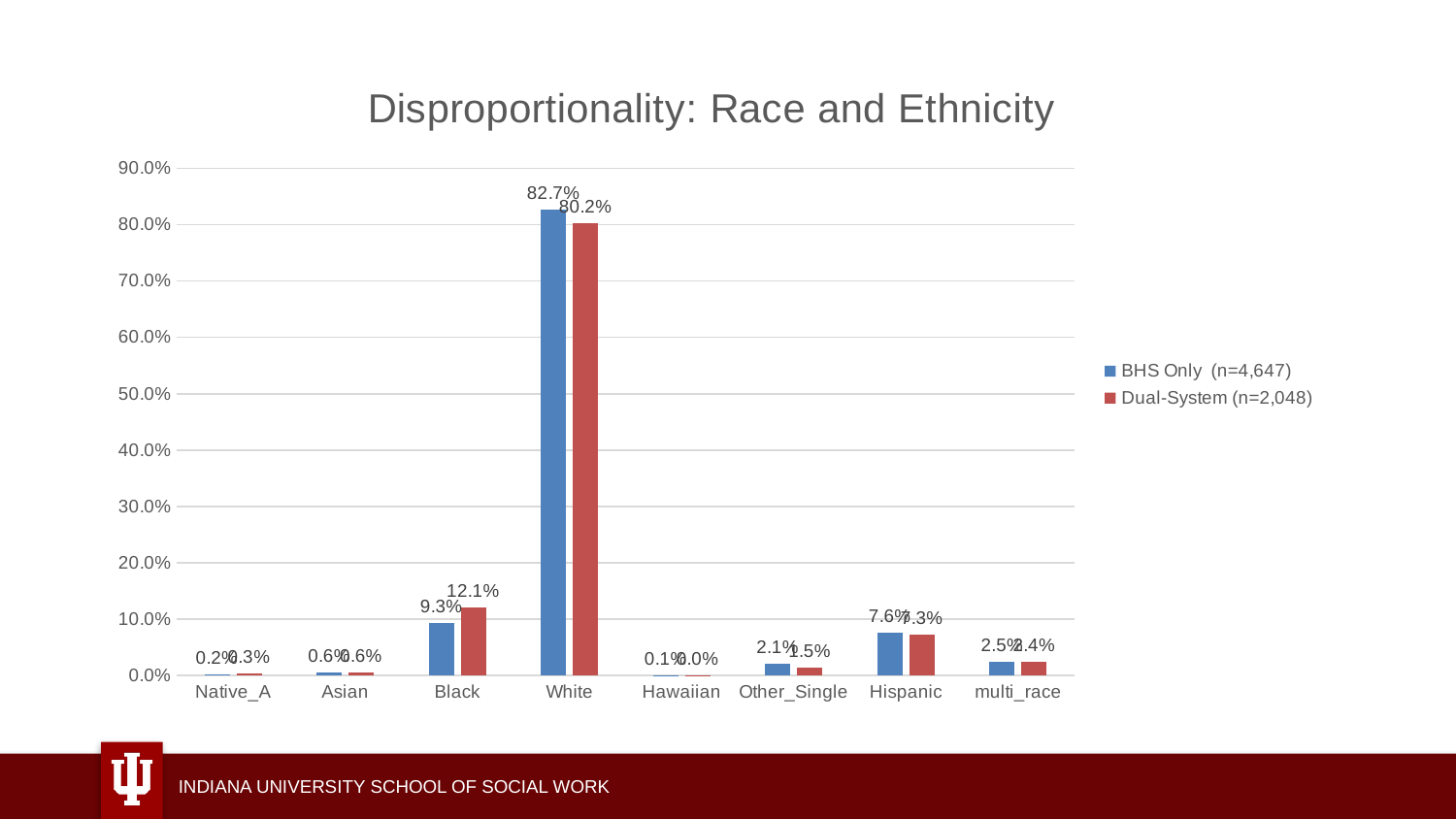
What is the difference between the Dual-System and BHS Only values for Black? 2.8 percentage points What kind of chart is shown on the slide? Bar chart What is the BHS Only value for Black? 9.3% Which category has the highest BHS Only value? White Is the BHS Only value for Hispanic greater or less than 10.0%? less What is the BHS Only value for White? 82.7% How many series does the legend list? 2 What is the Dual-System value for White? 80.2% What is the difference between the BHS Only and Dual-System values for White? 2.5 percentage points For Black, which series has the larger value, BHS Only or Dual-System? Dual-System How many race/ethnicity categories are shown on the x axis? 8 What is the Dual-System value for Black? 12.1%